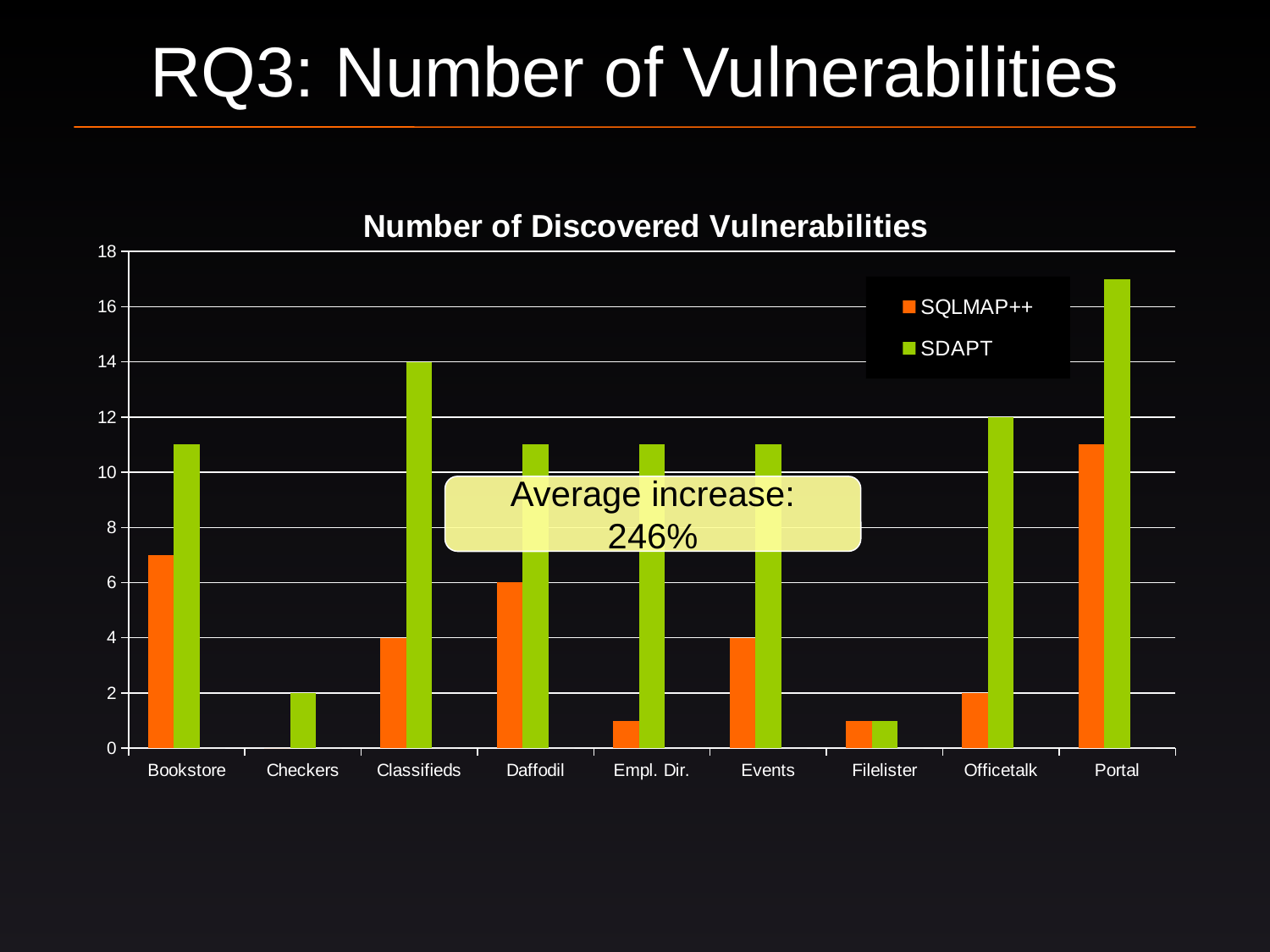
Which application has the lowest SDAPT value? Filelister What is the difference between the SDAPT and SQLMAP++ values for Officetalk? 10 How many applications (categories) are shown on the x axis? 9 How many series does the legend list? 2 What is the SQLMAP++ value for Daffodil? 6 What is the SDAPT value for Officetalk? 12 Is the SDAPT value for Portal greater or less than 16? greater Which application has the highest SDAPT value? Portal What type of chart is shown on the slide? bar chart What is the SDAPT value for Classifieds? 14 What is the title of the chart? Number of Discovered Vulnerabilities What is the SQLMAP++ value for Classifieds? 4